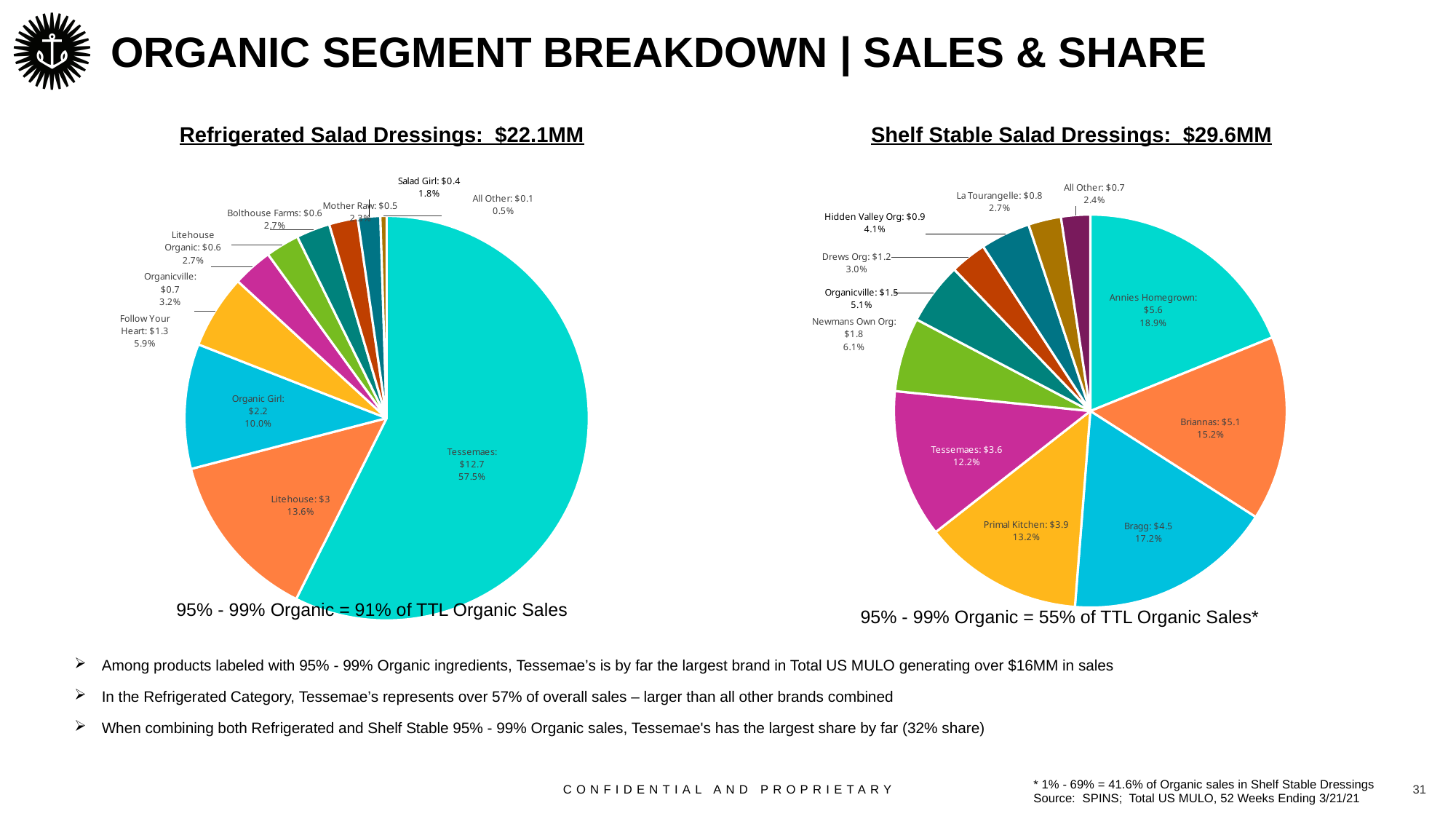
How many slices are shown in the Refrigerated Salad Dressings pie chart? 10 In the Refrigerated Salad Dressings chart, which brand has the smallest slice? All Other In the Refrigerated Salad Dressings chart, what are the sales for Tessemaes? $12.7 What type of chart is used for the Refrigerated Salad Dressings breakdown? Pie chart In the Refrigerated Salad Dressings chart, what is the difference in sales between Organic Girl and Follow Your Heart? $0.9 In the Shelf Stable Salad Dressings chart, what share of the pie does Tessemaes hold? 12.2% In the Refrigerated Salad Dressings chart, what share of the pie does Litehouse hold? 13.6% In the Shelf Stable Salad Dressings chart, which has higher sales, Newmans Own Org or Organicville? Newmans Own Org What total sales figure is given in the title of the Shelf Stable Salad Dressings chart? $29.6MM In the Shelf Stable Salad Dressings chart, which brand has the largest slice? Annies Homegrown How many slices are shown in the Shelf Stable Salad Dressings pie chart? 11 In the Shelf Stable Salad Dressings chart, what are the sales for Primal Kitchen? $3.9